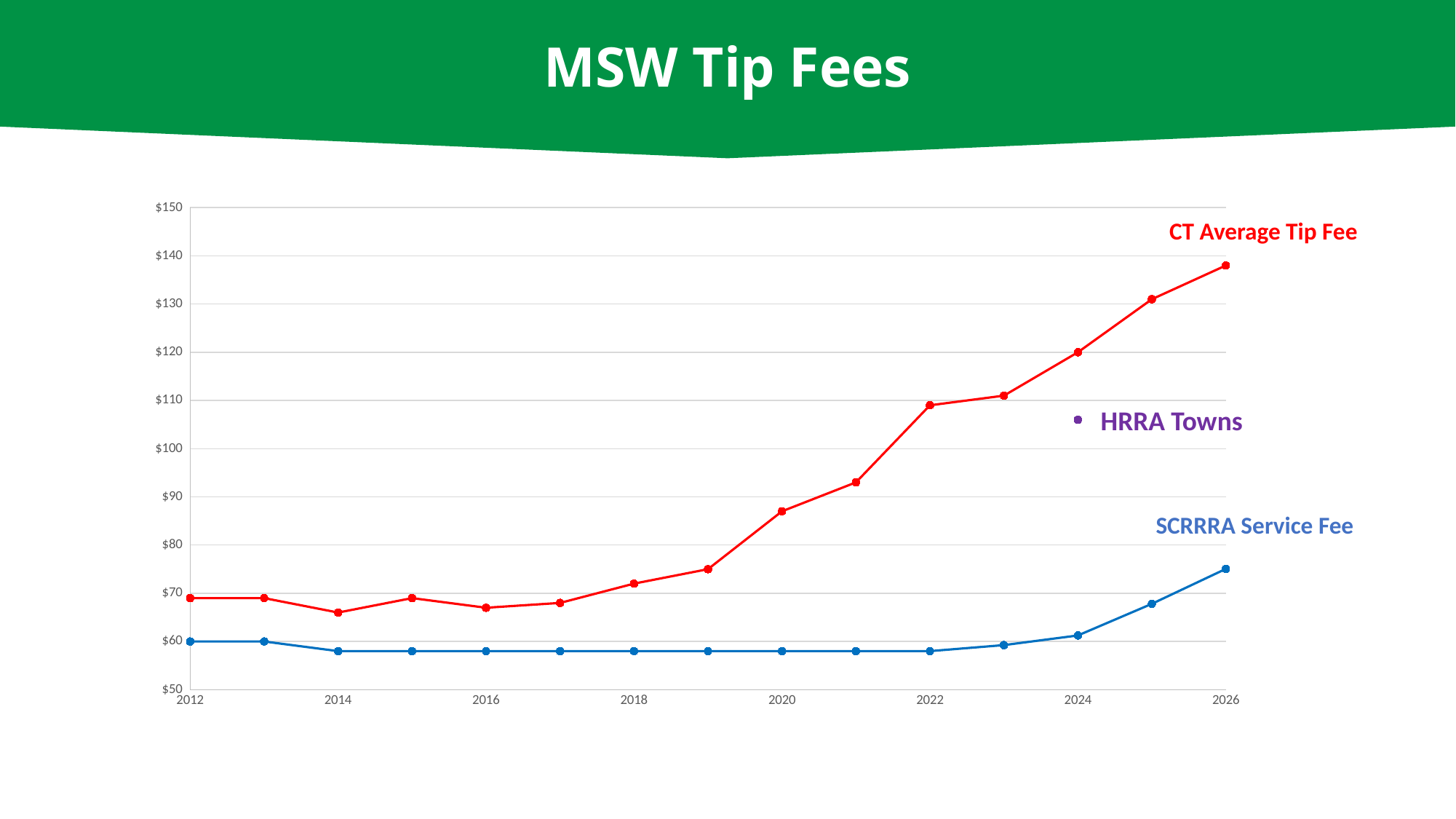
Is the SCRRRA Service Fee value for 2020 greater or less than $60? less In 2026, which is larger, the CT Average Tip Fee or the SCRRRA Service Fee? CT Average Tip Fee Is the SCRRRA Service Fee value for 2026 greater or less than $70? greater Does the CT Average Tip Fee rise or fall between 2018 and 2026? rise Is the CT Average Tip Fee value for 2026 greater or less than $130? greater How many lines are plotted on the chart? 2 What kind of chart is shown on the slide? line chart How many years are plotted along the x axis, from 2012 to 2026? 15 In which year is the CT Average Tip Fee highest? 2026